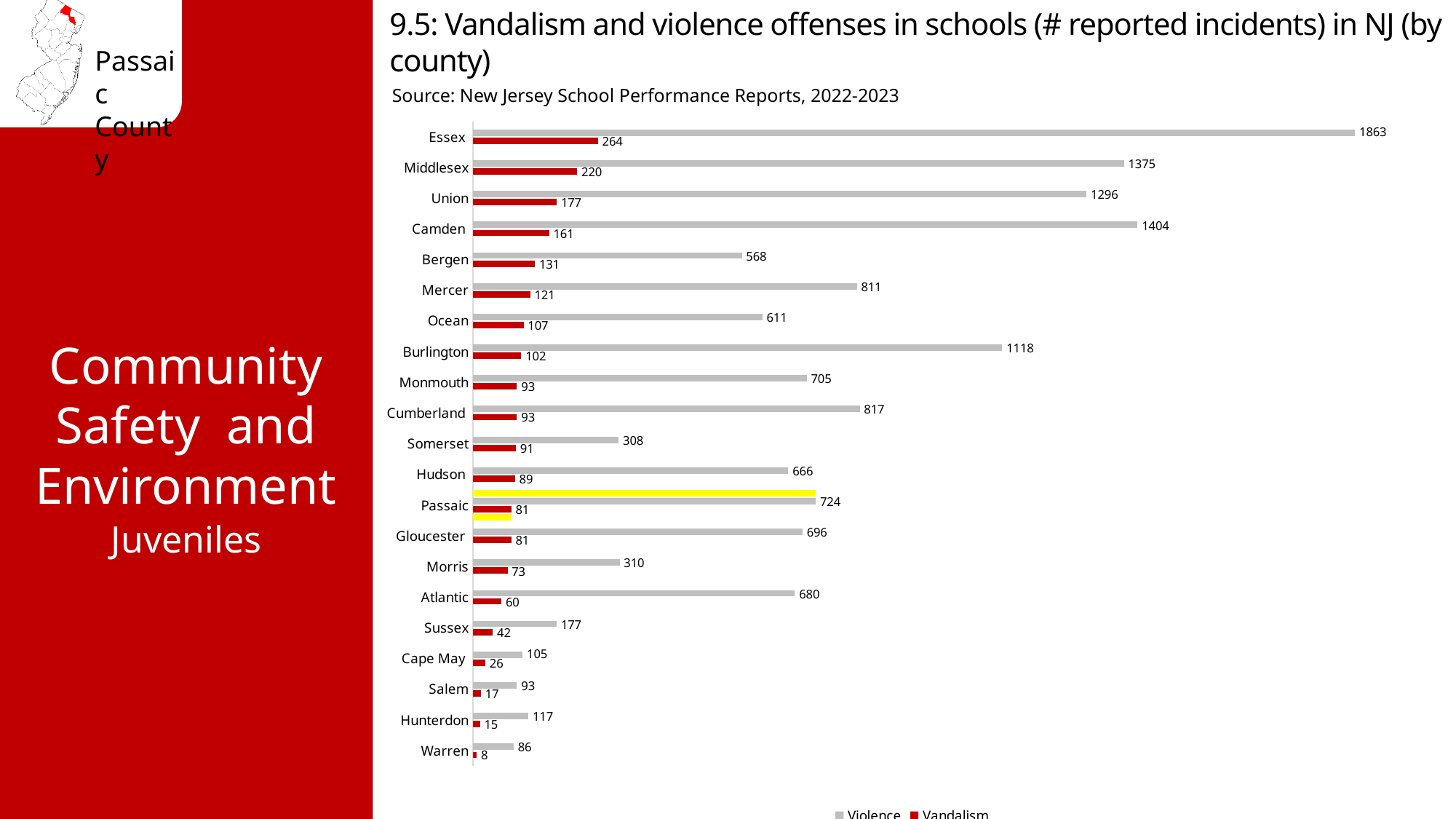
What is the number of reported vandalism incidents for Essex County? 264 Which county has the lowest number of reported vandalism incidents? Warren How many counties are shown on the chart? 21 What is the difference between the vandalism incidents in Essex and Middlesex? 44 What is the number of reported violence incidents for Passaic County? 724 Which county has the highest number of reported violence incidents? Essex What is the number of reported vandalism incidents for Hunterdon County? 15 What kind of chart is shown on the slide? Bar chart Which county has more reported violence incidents, Passaic or Gloucester? Passaic How many series does the legend list? 2 Which series is shown in red on the chart? Vandalism What is the difference between the violence incidents in Camden and Middlesex? 29